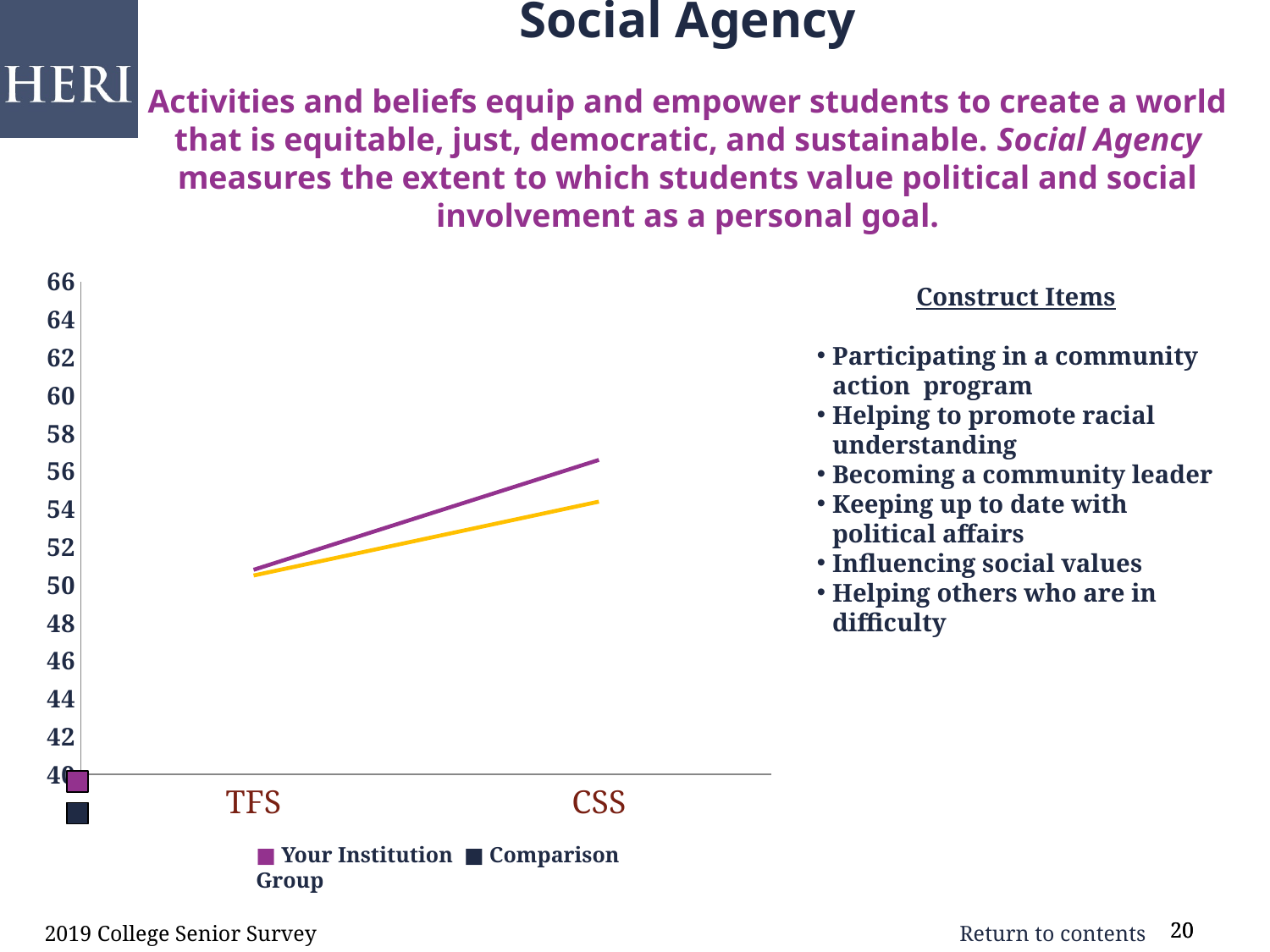
Is the value for Your Institution at TFS greater or less than 48? greater How many categories are shown on the x axis of the chart? 2 At which category does the Your Institution line reach its highest value? CSS What are the two series named in the chart legend? Your Institution and Comparison Group Does the Your Institution line rise or fall from TFS to CSS? rise What kind of chart is shown on the slide? line chart Is the value for Your Institution at TFS greater or less than 54? less Is the value for Your Institution at CSS greater or less than 54? greater For Your Institution, which is larger, the value at TFS or the value at CSS? CSS What are the two category labels on the x axis of the chart? TFS and CSS How many series does the chart legend list? 2